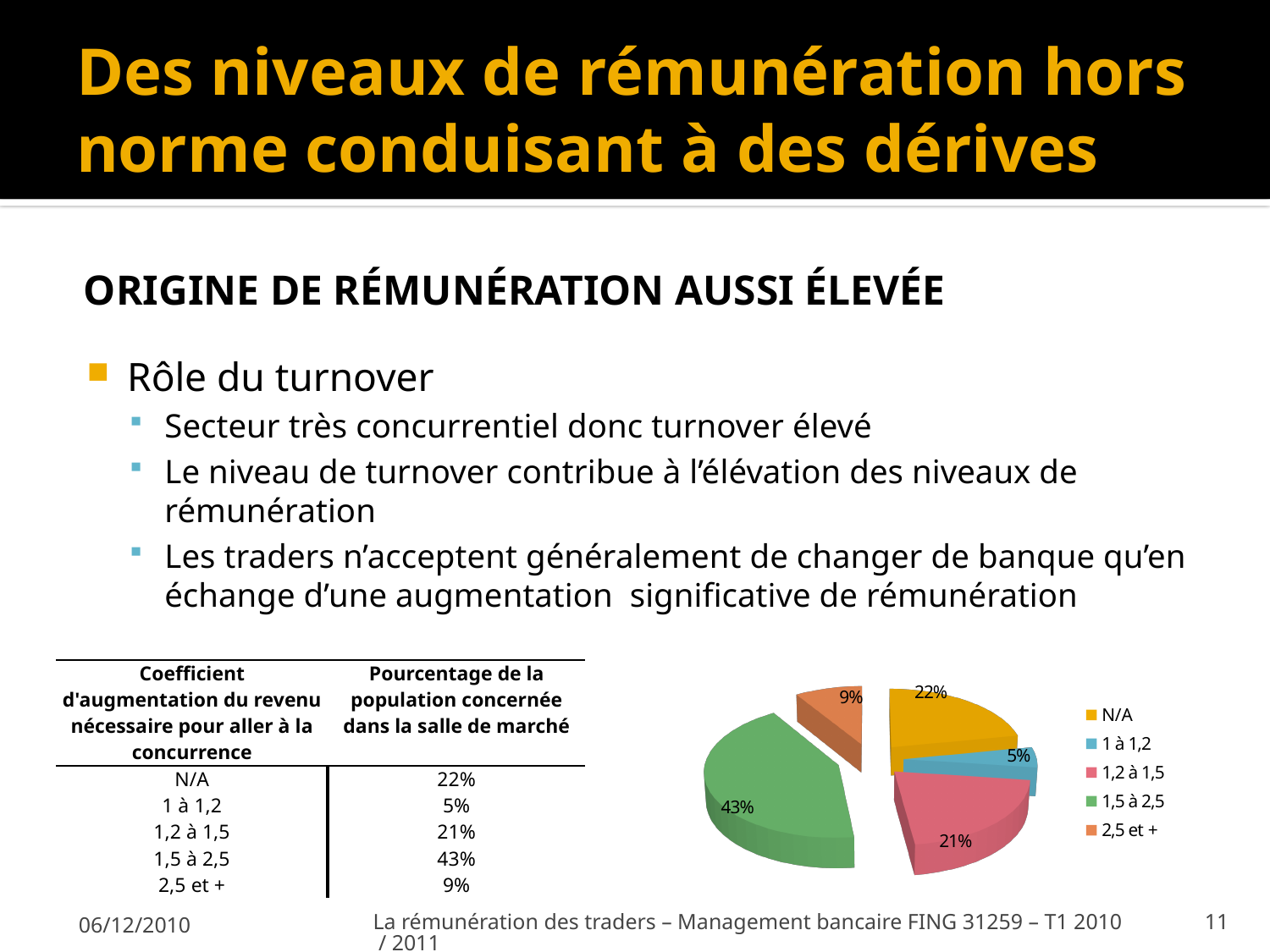
What is the value shown for the "N/A" slice of the pie chart? 22% What is the value shown for the "1 à 1,2" slice of the pie chart? 5% How many entries does the legend of the pie chart list? 5 Which category has the smallest slice in the pie chart? 1 à 1,2 What colour is the "1,5 à 2,5" slice in the pie chart? green Which category has the largest slice in the pie chart? 1,5 à 2,5 What is the value shown for the "2,5 et +" slice of the pie chart? 9% What is the difference between the "1,5 à 2,5" slice and the "N/A" slice? 21% What share of the pie does the "1,5 à 2,5" slice represent? 43% Which is larger in the pie chart: the "1,2 à 1,5" slice or the "2,5 et +" slice? 1,2 à 1,5 How many slices does the pie chart have? 5 What kind of chart is shown on the slide? pie chart